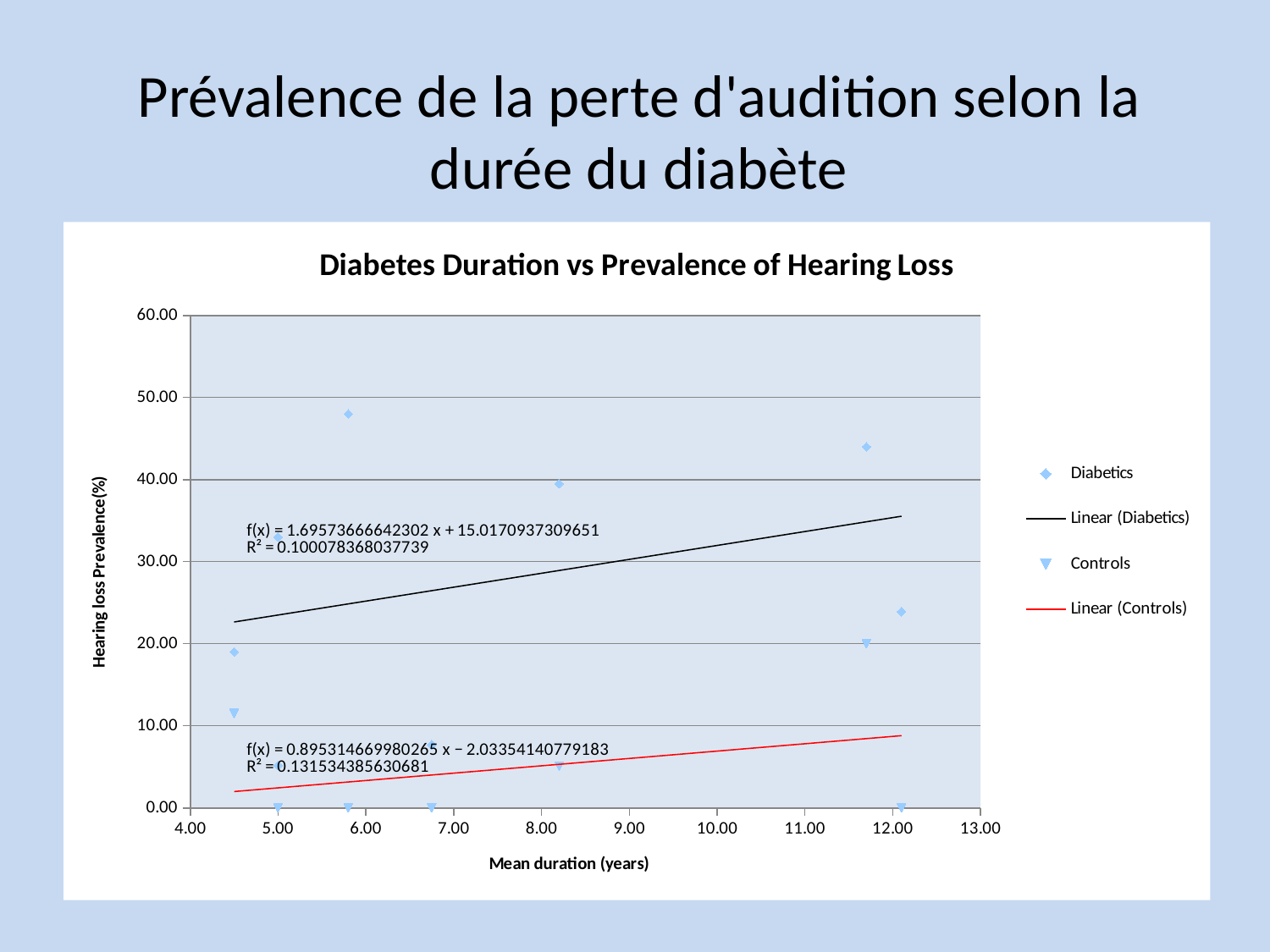
Is the hearing loss prevalence for the Controls point at a mean duration of about 4.5 years greater or less than 20.00? less Which trendline lies higher on the chart, Linear (Diabetics) or Linear (Controls)? Linear (Diabetics) What is the label of the x axis? Mean duration (years) What is the title of the chart? Diabetes Duration vs Prevalence of Hearing Loss What R² value is printed for the Controls trendline? 0.131534385630681 Does the Linear (Controls) trendline rise or fall as mean duration increases? Rises Is the hearing loss prevalence for the Diabetics point at a mean duration of about 12.1 years greater or less than 30.00? less How many entries does the chart legend list? 4 What kind of chart is shown on the slide? Scatter chart What R² value is printed for the Diabetics trendline? 0.100078368037739 Does the Linear (Diabetics) trendline rise or fall as mean duration increases? Rises Is the hearing loss prevalence for the Diabetics point at a mean duration of about 5.8 years greater or less than 40.00? greater